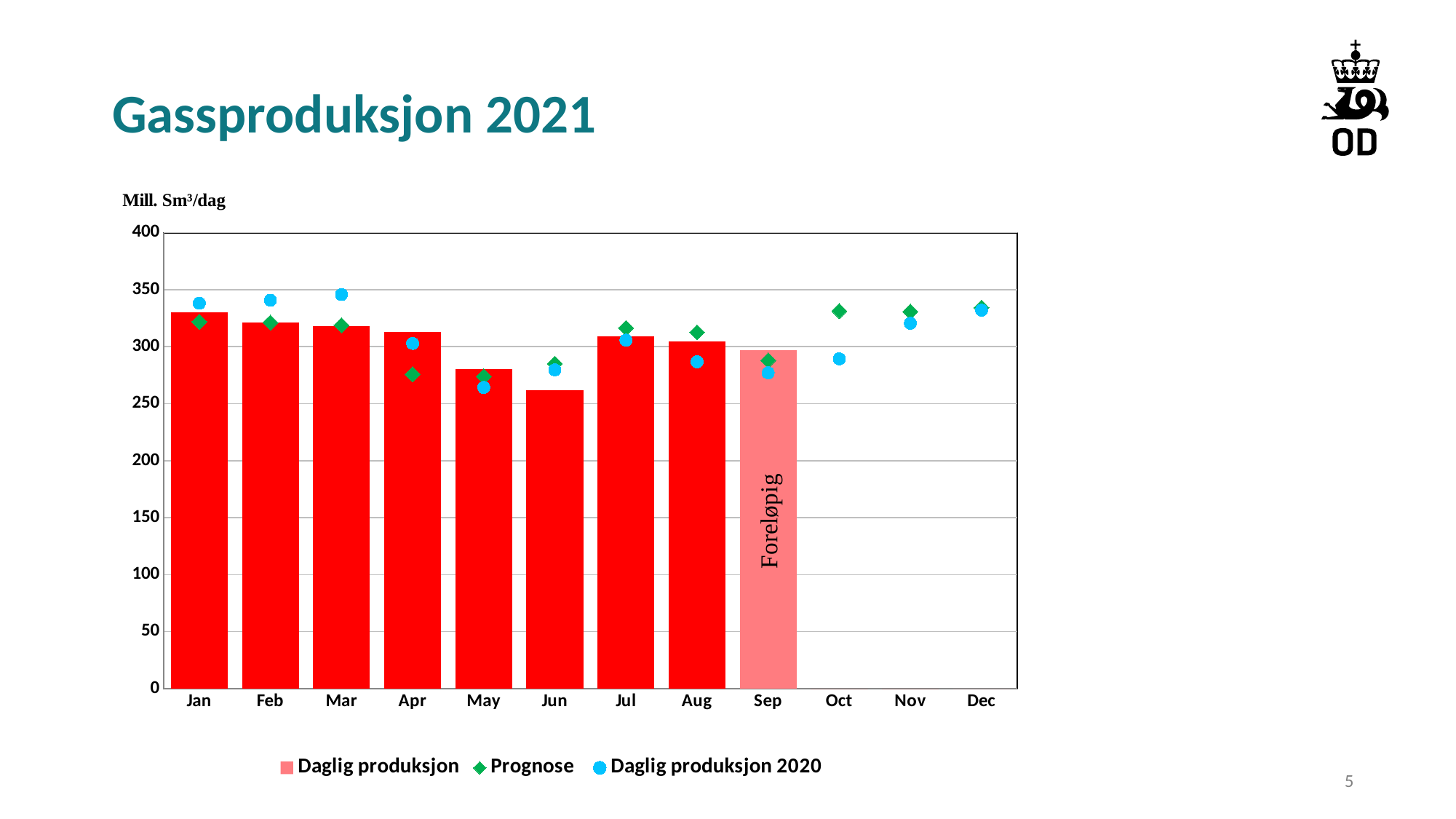
What is the title of the chart? Gassproduksjon 2021 Is the Daglig produksjon value for Jan greater or less than 300? greater Is the Daglig produksjon value for Jun greater or less than 300? less What label is written on the Sep bar? Foreløpig How many months have a Daglig produksjon bar? 9 How many series does the legend list? 3 Which is larger, the Daglig produksjon bar for Jul or for May? Jul Do the Daglig produksjon bars rise or fall from Jan to Jun? fall Which month has the lowest Daglig produksjon bar? Jun How many months are shown on the x axis? 12 Which month has the highest Daglig produksjon bar? Jan What kind of chart is used to show Daglig produksjon? bar chart